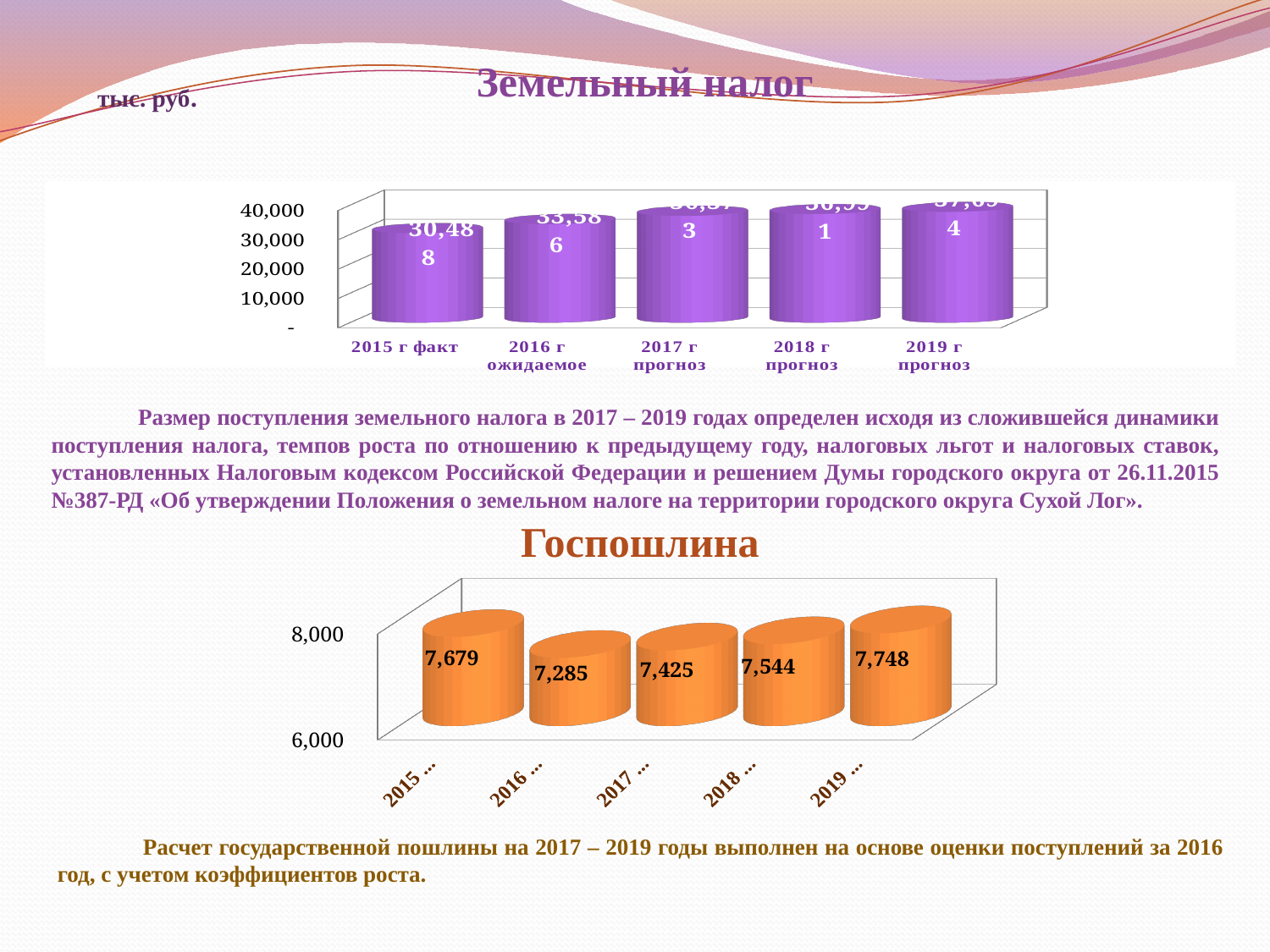
In the Госпошлина chart, what is the difference between the 2019 value and the 2018 value? 204 In the Земельный налог chart, do the values rise or fall from 2015 to 2019? rise In the Госпошлина chart, which year has the lowest value? 2016 In the Земельный налог chart, what is the difference between the 2016 г ожидаемое value and the 2015 г факт value? 3,098 In the Земельный налог chart, what is the value for 2015 г факт? 30,488 In the Земельный налог chart, what is the value for 2016 г ожидаемое? 33,586 In the Госпошлина chart, what is the value for 2015? 7,679 How many categories are shown in the Земельный налог chart? 5 In the Земельный налог chart, which category has the lowest value? 2015 г факт In the Госпошлина chart, which year has the highest value? 2019 In the Земельный налог chart, is the value for 2015 г факт greater or less than 20,000? greater What type of chart is the Госпошлина chart? bar chart